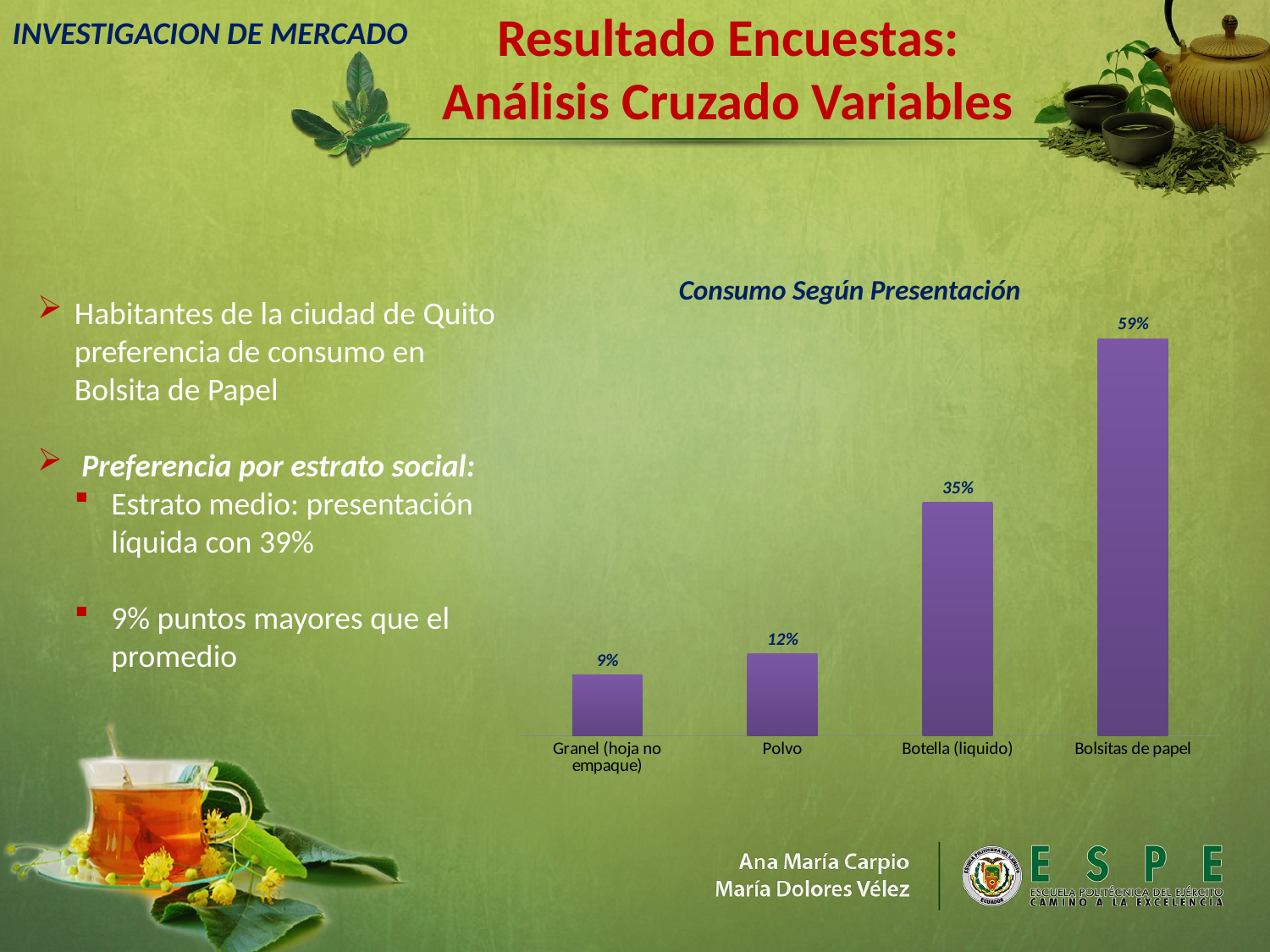
What is the value for Bolsitas de papel in the Consumo Según Presentación chart? 59% Which is larger, the value for Polvo or the value for Botella (liquido)? Botella (liquido) What is the title of the chart on the slide? Consumo Según Presentación What is the difference between the values for Polvo and Granel (hoja no empaque)? 3% What is the difference between the values for Bolsitas de papel and Botella (liquido)? 24% How many categories are shown in the chart? 4 What is the value for Botella (liquido) in the chart? 35% Which category has the highest value in the chart? Bolsitas de papel Which category has the lowest value in the chart? Granel (hoja no empaque) What is the value for Granel (hoja no empaque) in the chart? 9% What is the value for Polvo in the chart? 12% What kind of chart is shown on the slide? Bar chart